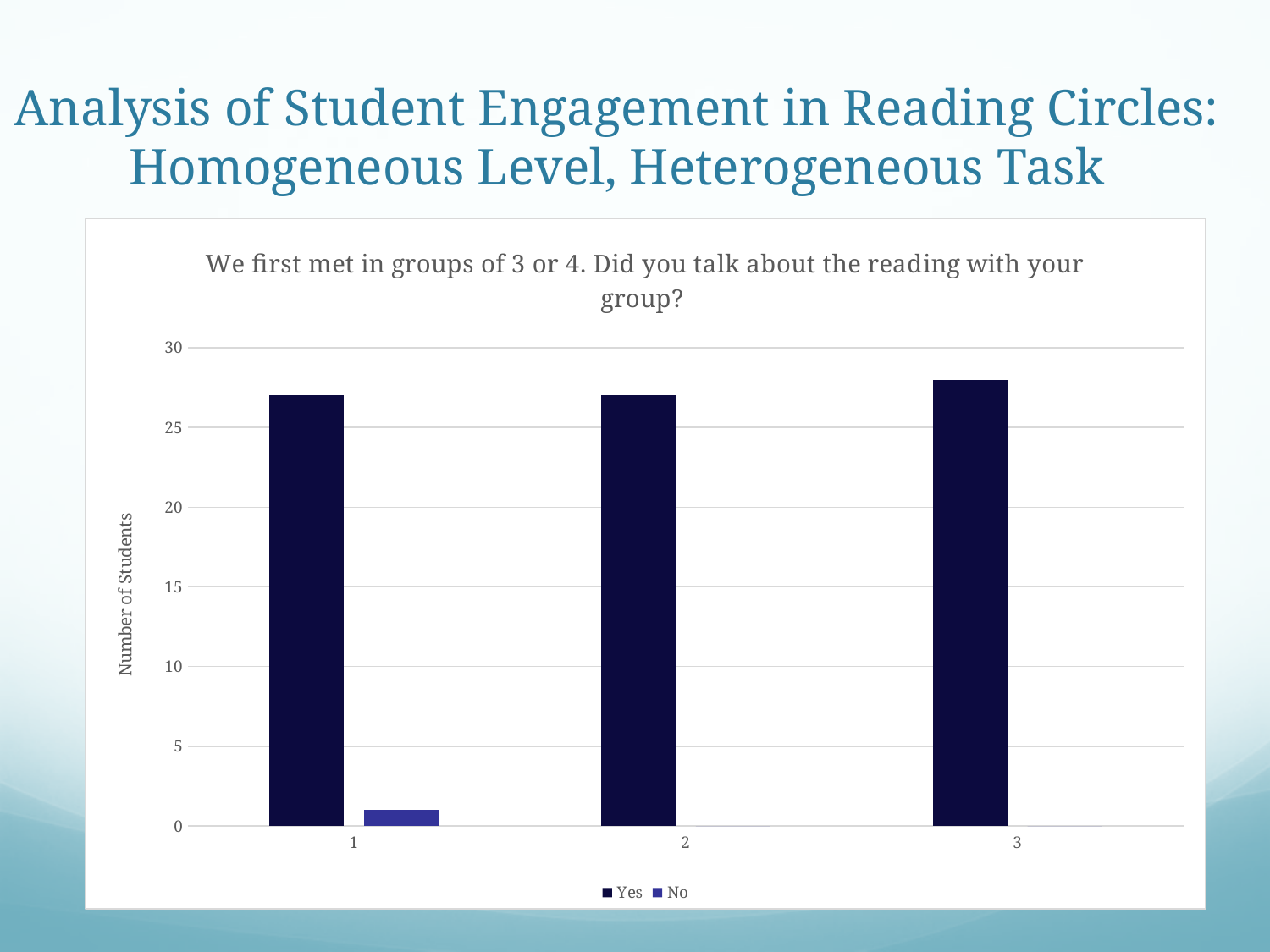
What kind of chart is shown on the slide? bar chart Is the value for No in category 1 greater or less than 5? less How many series does the chart's legend list? 2 What are the two series named in the chart's legend? Yes and No What is the label on the vertical axis of the chart? Number of Students In category 1, which is larger, the Yes value or the No value? Yes Is the value for Yes in category 2 greater or less than 30? less Is the value for Yes in category 3 greater or less than 25? greater How many categories are shown on the x axis of the chart? 3 In category 3, which is larger, the Yes value or the No value? Yes